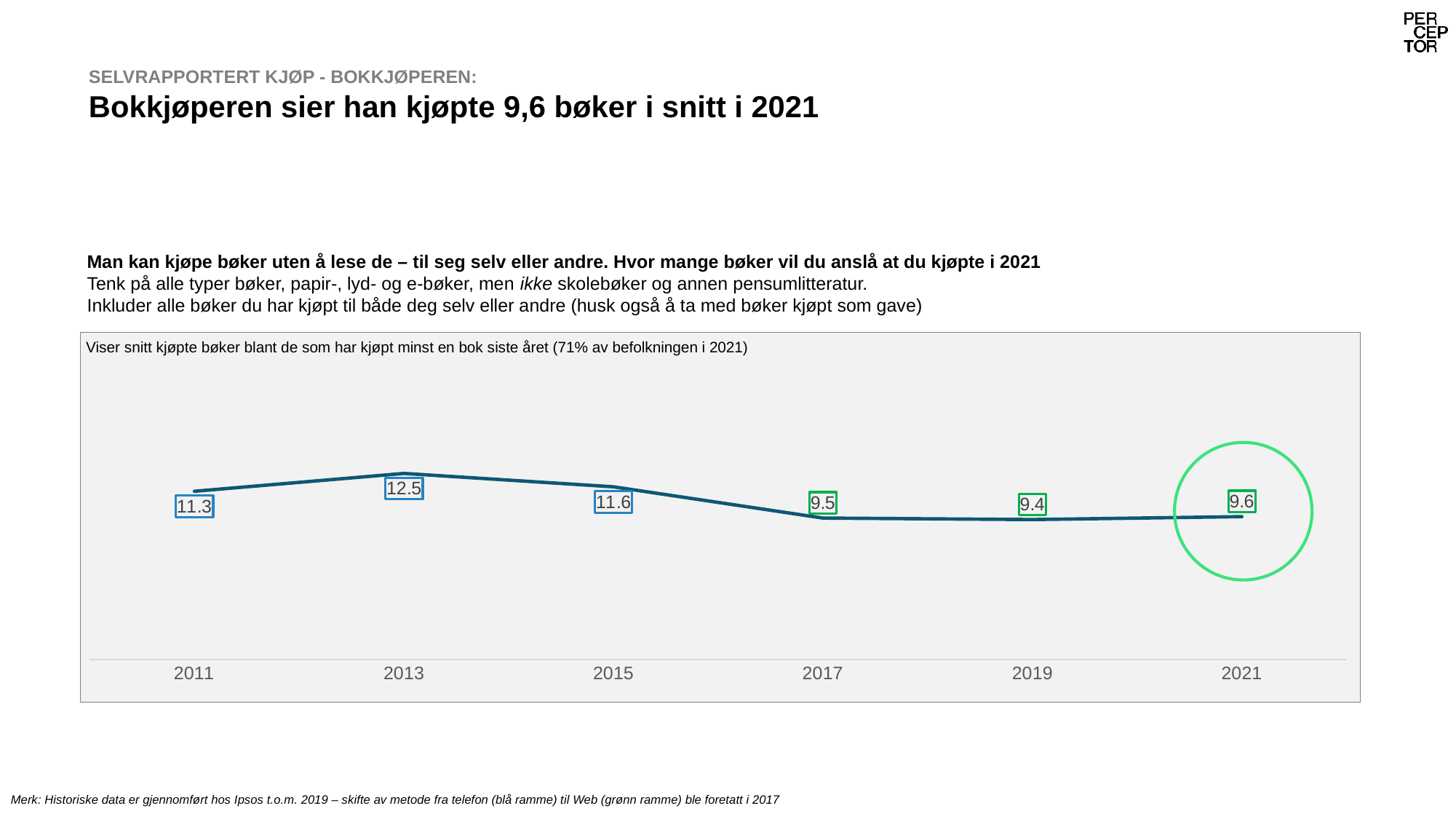
Which is larger, the value for 2011 or the value for 2015? 2015 What is the value shown for 2017? 9.5 Which year's data point is highlighted with a green circle? 2021 What kind of chart is shown? line chart How many years are plotted on the chart? 6 Which year has the highest value? 2013 What is the difference between the values for 2013 and 2021? 2.9 Do the values rise or fall from 2013 to 2019? fall What is the difference between the values for 2011 and 2013? 1.2 What is the average number of books bought in 2021? 9.6 What is the value shown for 2013? 12.5 Which year has the lowest value? 2019